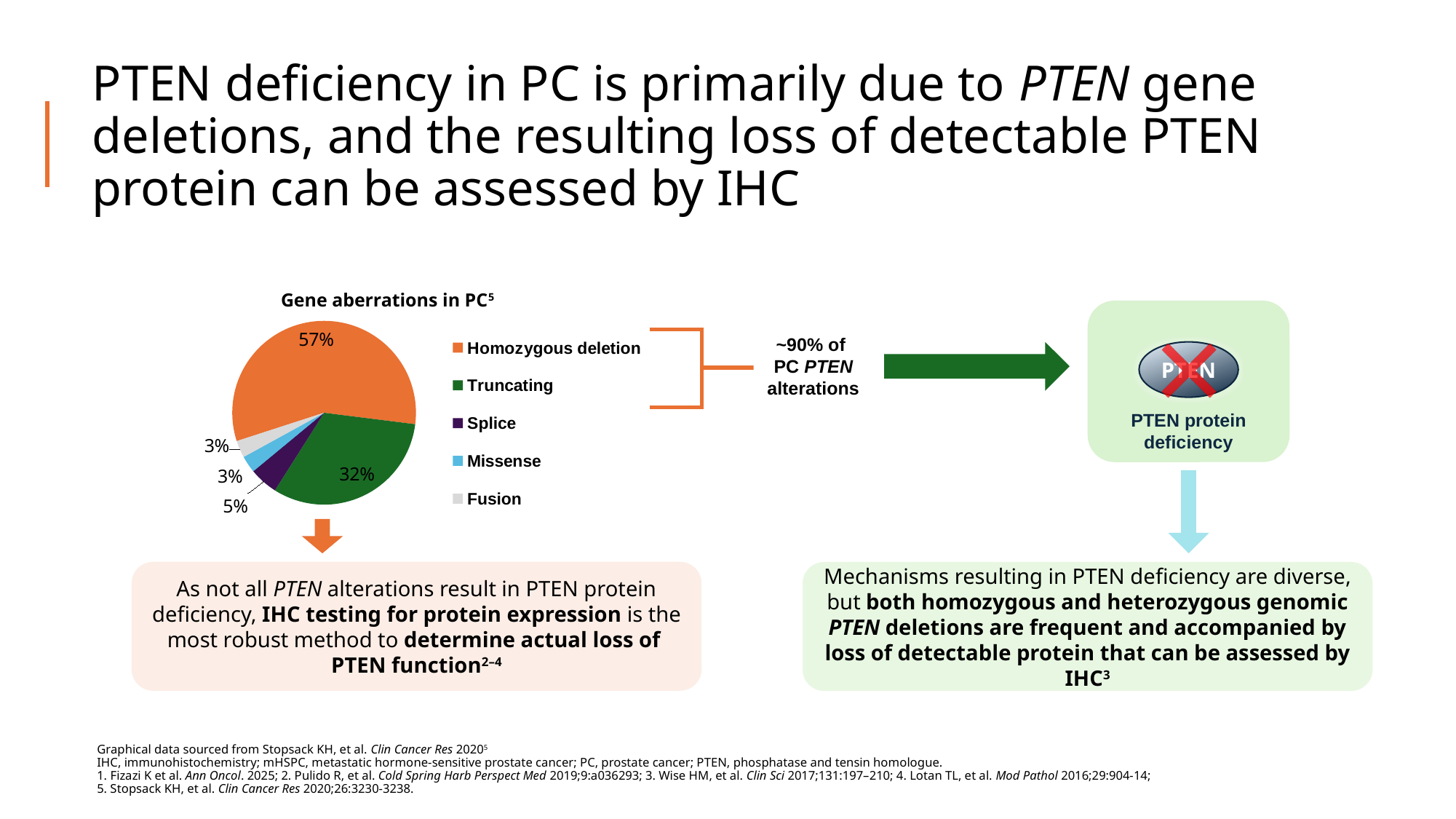
What is the difference in percentage points between homozygous deletion and truncating aberrations? 25 Which is larger in the pie chart: the truncating share or the splice share? Truncating What is the title of the pie chart? Gene aberrations in PC What is the combined share of homozygous deletion and truncating aberrations in the pie chart? 89% What percentage of gene aberrations in PC are homozygous deletions? 57% What percentage of gene aberrations in PC are splice aberrations? 5% What percentage of gene aberrations in PC are truncating? 32% Which colour represents homozygous deletion in the pie chart? Orange How many categories does the legend of the pie chart list? 5 Which category accounts for the largest share of gene aberrations in PC? Homozygous deletion What percentage of gene aberrations in PC are missense? 3% What type of chart is shown under the title 'Gene aberrations in PC'? Pie chart